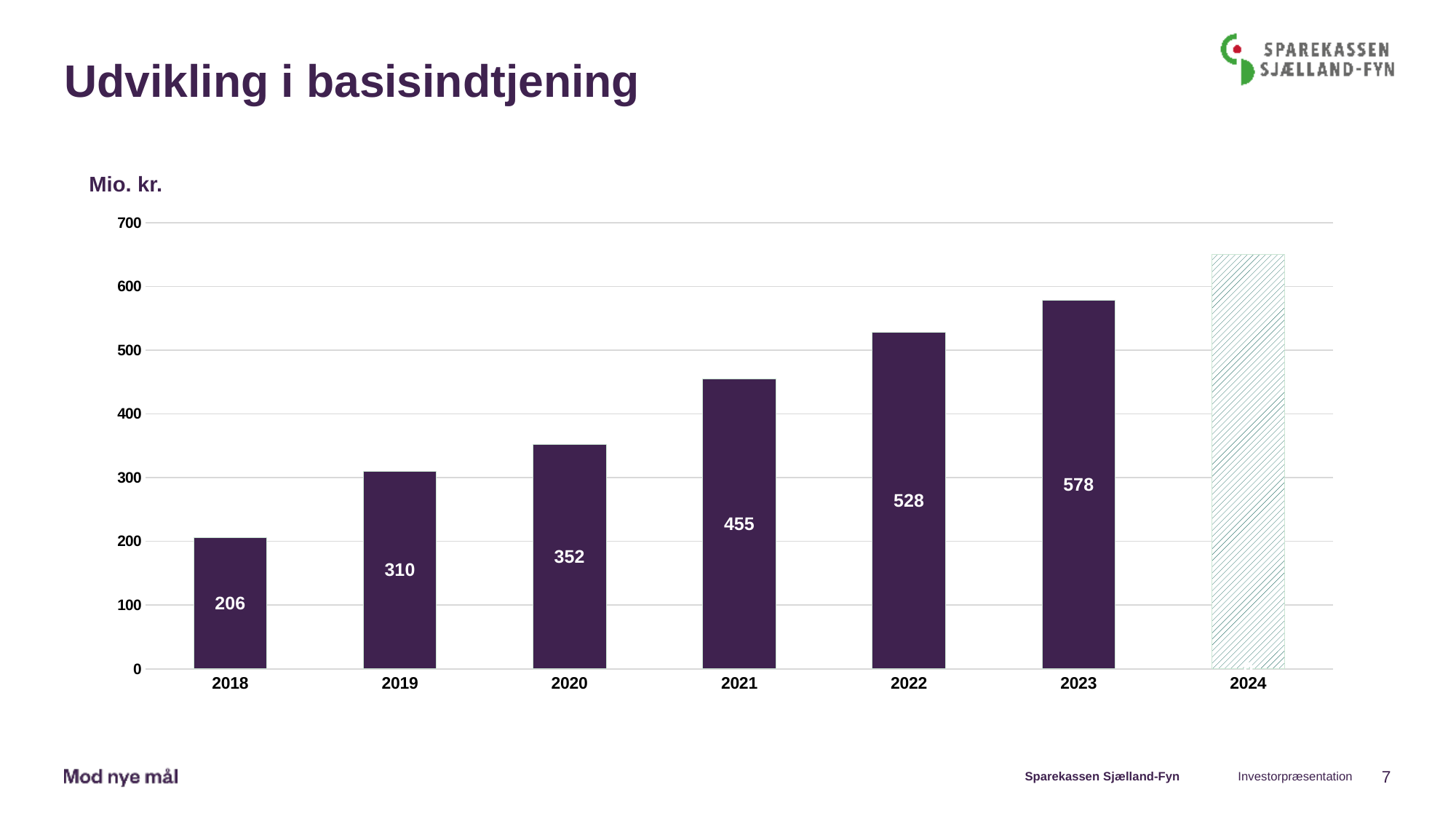
Which is larger, the value for 2020 or the value for 2021? 2021 Is the value for 2024 greater or less than 600? greater Which year has the highest value among the labelled bars? 2023 Which year has the lowest value? 2018 What kind of chart is shown? bar chart What is the difference between the values for 2023 and 2022? 50 What is the value for 2021? 455 Do the values rise or fall from 2018 to 2023? rise How many years are shown on the x axis? 7 What is the value for 2018? 206 What is the value for 2023? 578 What is the difference between the values for 2019 and 2018? 104